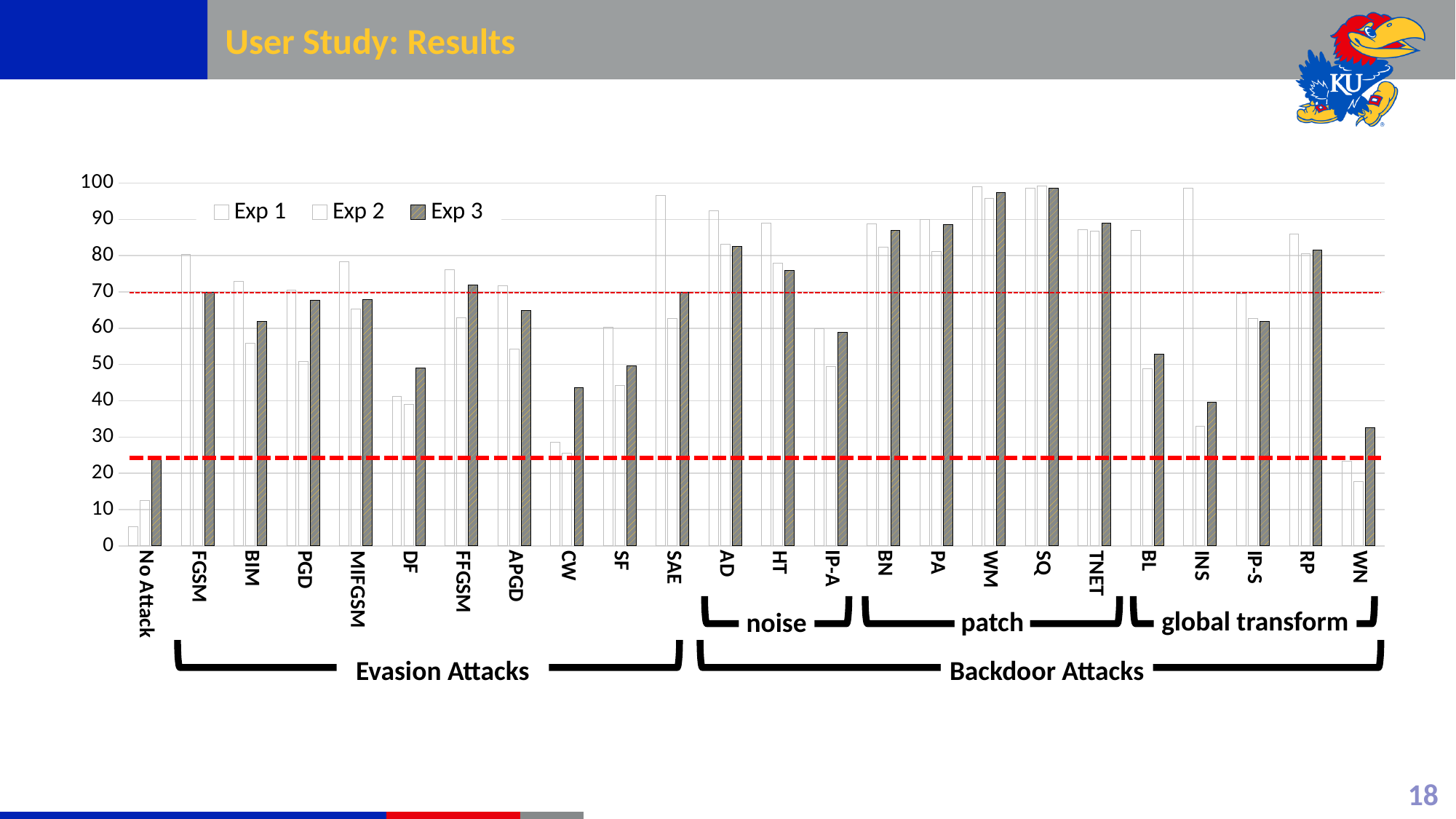
Is the Exp 3 value for HT greater or less than 70? greater How many series does the legend list? 3 Is the Exp 1 value for SAE greater or less than 90? greater Is the Exp 3 value for No Attack greater or less than 30? less What kind of chart is shown on the slide? bar chart Which category has the lowest Exp 3 value? No Attack What are the series names listed in the legend? Exp 1, Exp 2, Exp 3 How many attack categories are shown along the x axis? 24 Which has the larger Exp 3 value, BN or INS? BN Which has the larger Exp 3 value, SQ or CW? SQ